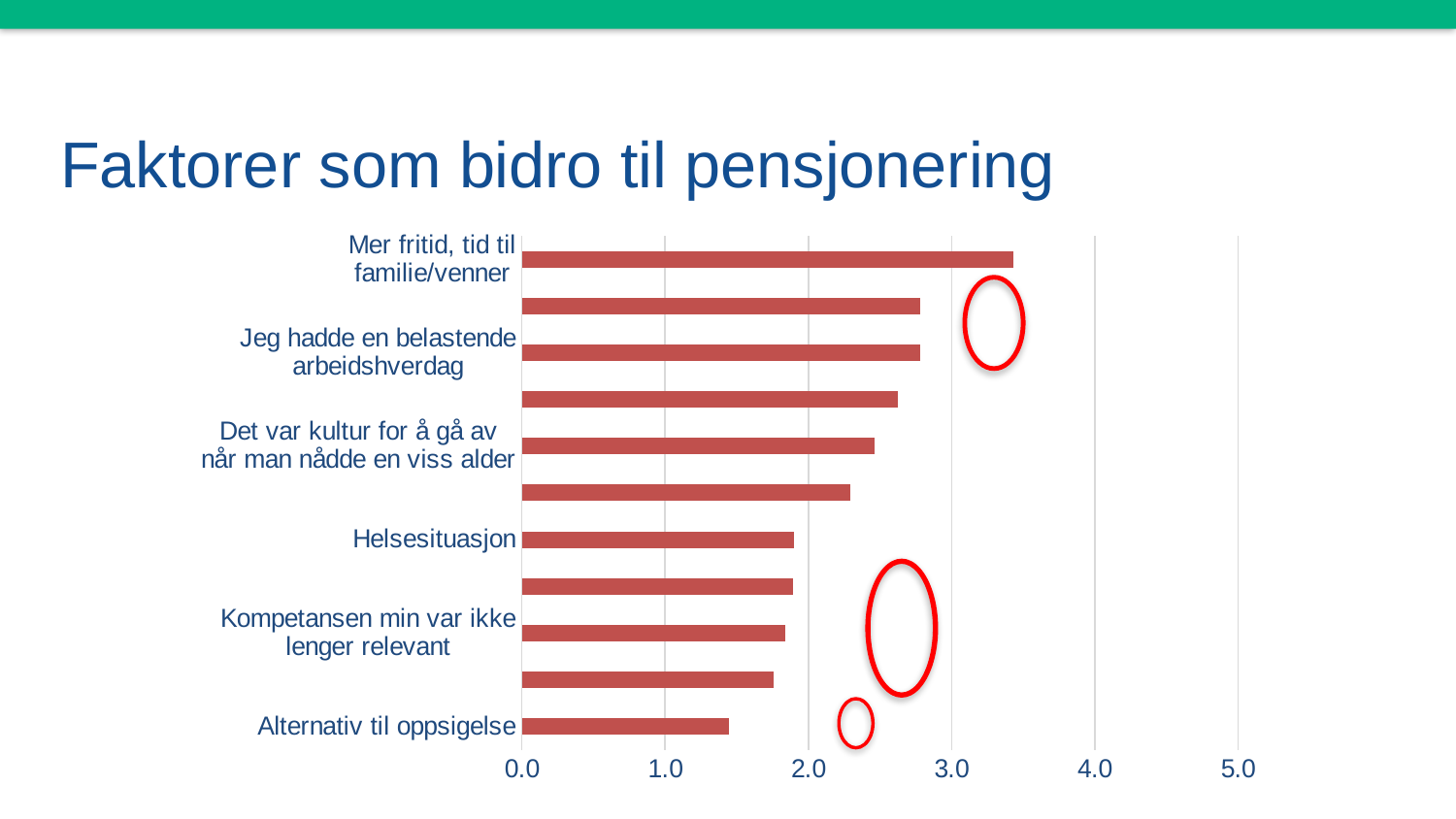
How many bars are plotted in the chart? 11 Which is larger, the value for 'Mer fritid, tid til familie/venner' or the value for 'Helsesituasjon'? Mer fritid, tid til familie/venner Which labelled category has the shortest bar? Alternativ til oppsigelse Is the value for 'Det var kultur for å gå av når man nådde en viss alder' greater or less than 2.0? greater Is the value for 'Jeg hadde en belastende arbeidshverdag' greater or less than 3.0? less Which is larger, the value for 'Alternativ til oppsigelse' or the value for 'Jeg hadde en belastende arbeidshverdag'? Jeg hadde en belastende arbeidshverdag What kind of chart is shown on the slide? bar chart Is the value for 'Mer fritid, tid til familie/venner' greater or less than 3.0? greater Which labelled category has the longest bar? Mer fritid, tid til familie/venner What is the title of the slide? Faktorer som bidro til pensjonering